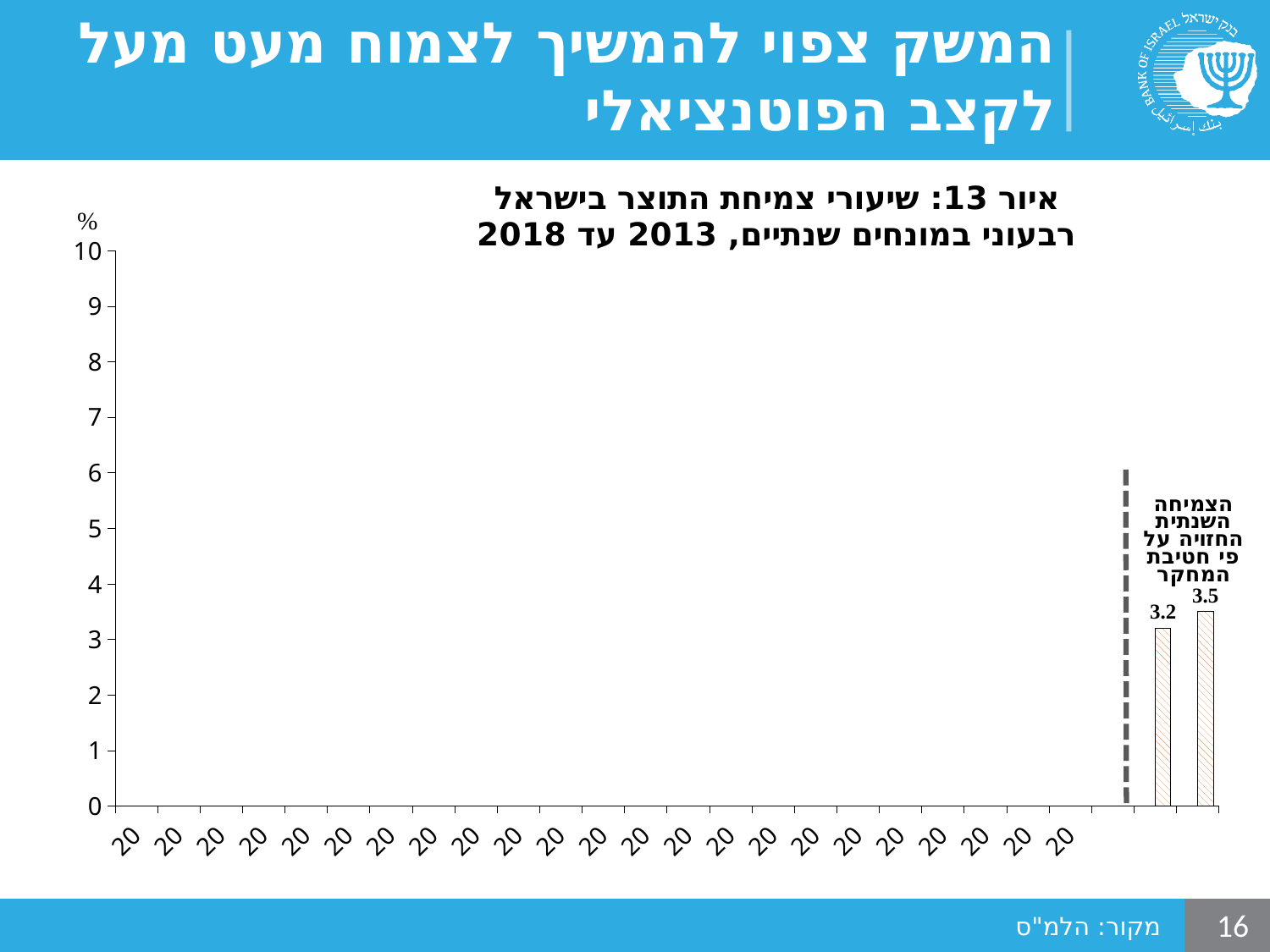
What is the value labelled on the rightmost bar of the chart? 3.5 Which of the two bars is taller, the left one (3.2) or the rightmost one (3.5)? the rightmost one (3.5) How many bars are plotted in the chart? 2 What is the difference between the two labelled bar values, 3.5 and 3.2? 0.3 What kind of chart is shown on the slide? bar chart Is the value of the left of the two bars greater or less than 3? greater What is the value labelled on the left of the two bars at the right side of the chart? 3.2 Is the value of the rightmost bar greater or less than 4? less What is the lowest value labelled on any bar in the chart? 3.2 What is the highest value labelled on any bar in the chart? 3.5 What is the maximum value shown on the y-axis? 10 What unit is shown at the top of the y-axis? %